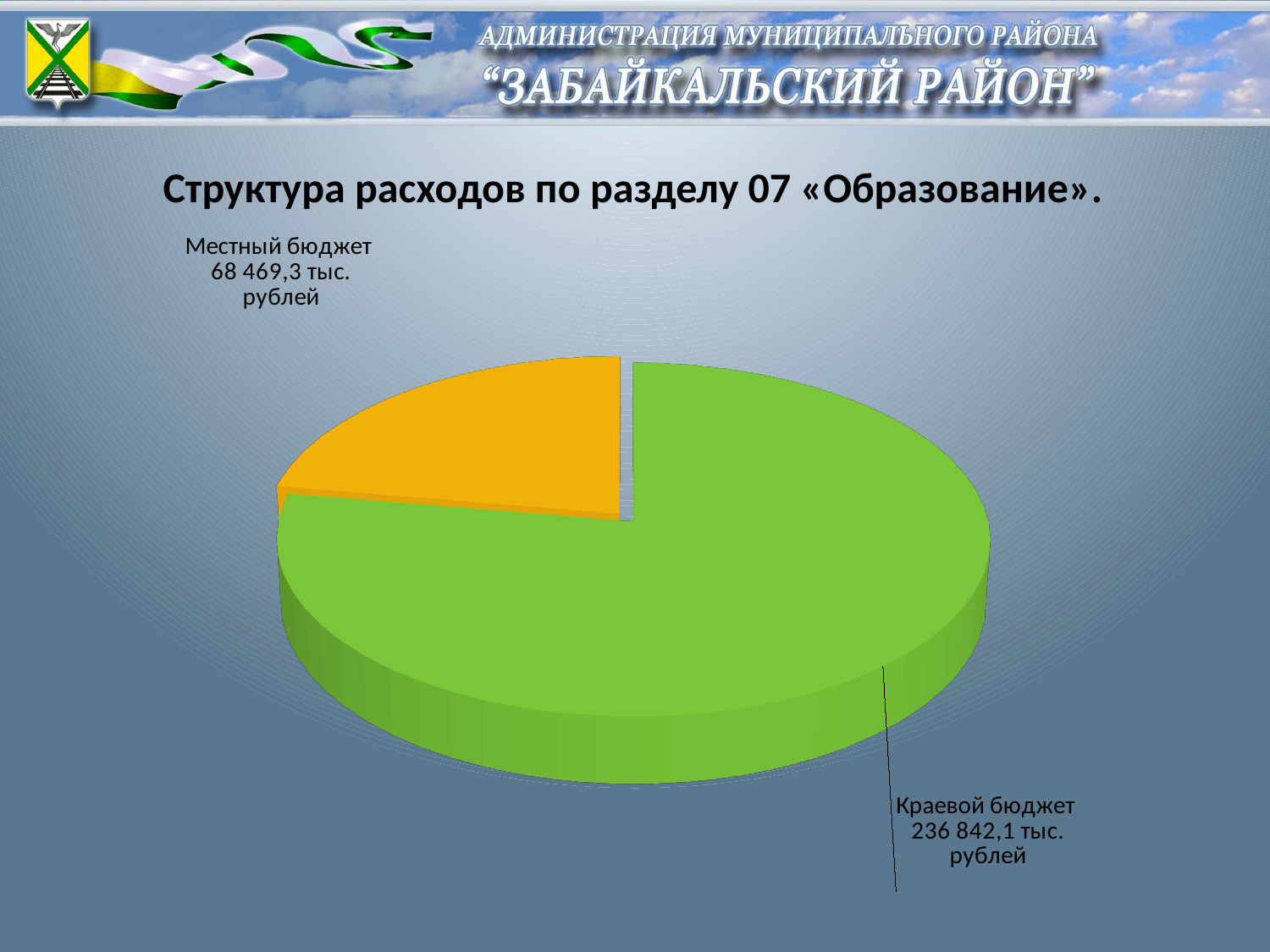
Which slice is the smallest? Местный бюджет What kind of chart is shown on the slide? Pie chart Which slice is the largest? Краевой бюджет How many slices does the pie chart have? 2 What is the total of the two slices? 305 311,4 тыс. рублей What is the value for Краевой бюджет? 236 842,1 тыс. рублей What is the difference between Краевой бюджет and Местный бюджет? 168 372,8 тыс. рублей What is the value for Местный бюджет? 68 469,3 тыс. рублей Which is larger, Краевой бюджет or Местный бюджет? Краевой бюджет What colour is the Местный бюджет slice? Orange What is the title of the chart? Структура расходов по разделу 07 «Образование».